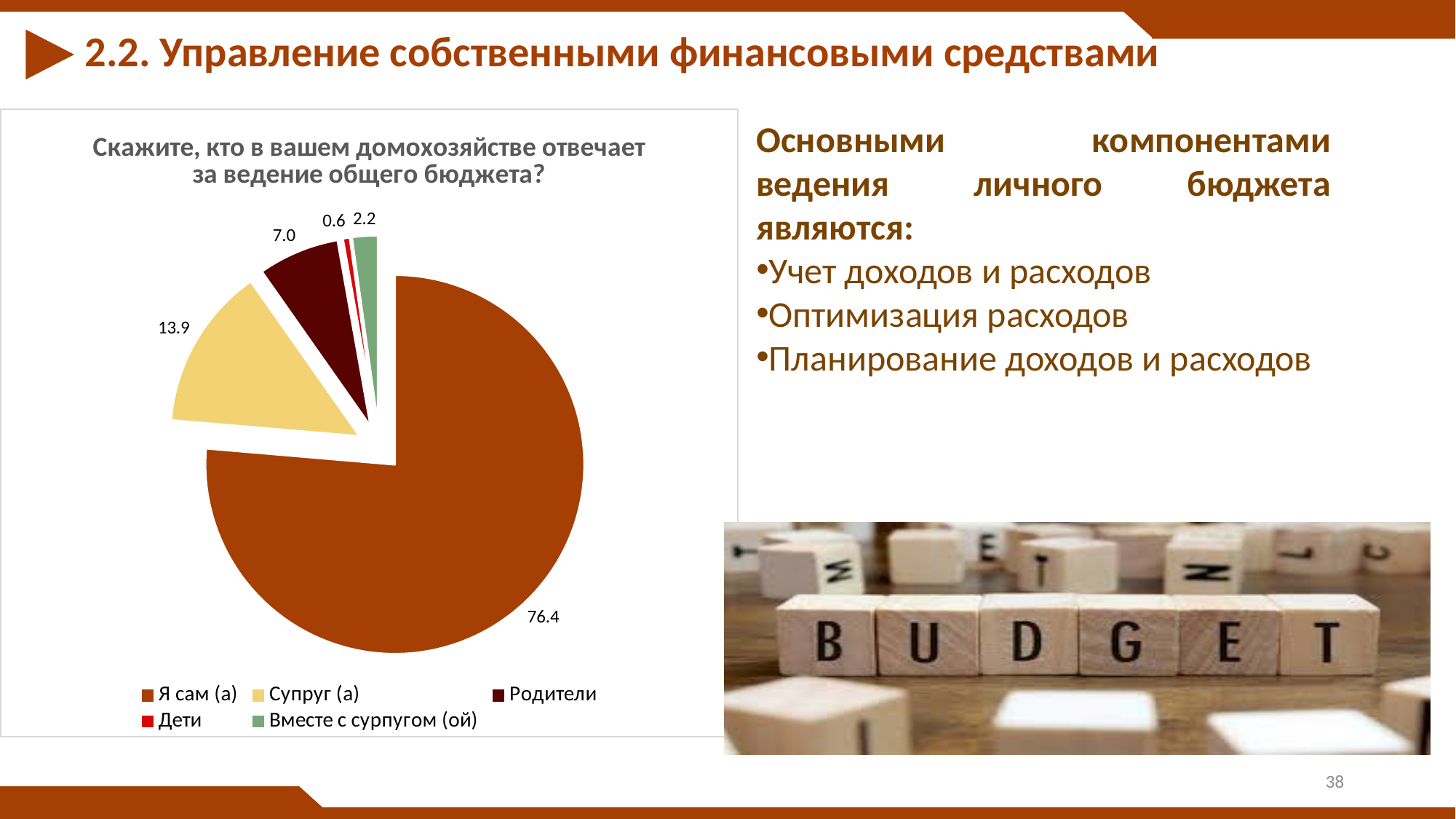
How many categories does the pie chart show? 5 What is the value for "Родители" in the pie chart? 7.0 Which category has the smallest slice in the pie chart? Дети What type of chart is shown on the slide? Pie chart What is the value for "Я сам (а)" in the pie chart? 76.4 What is the value for "Супруг (а)" in the pie chart? 13.9 Which category has the largest slice in the pie chart? Я сам (а) What is the value for "Вместе с сурпугом (ой)" in the pie chart? 2.2 Which is larger: the value for "Родители" or the value for "Вместе с сурпугом (ой)"? Родители What colour is the slice for "Супруг (а)" in the pie chart? Yellow What is the value for "Дети" in the pie chart? 0.6 What is the difference between the values for "Я сам (а)" and "Супруг (а)"? 62.5